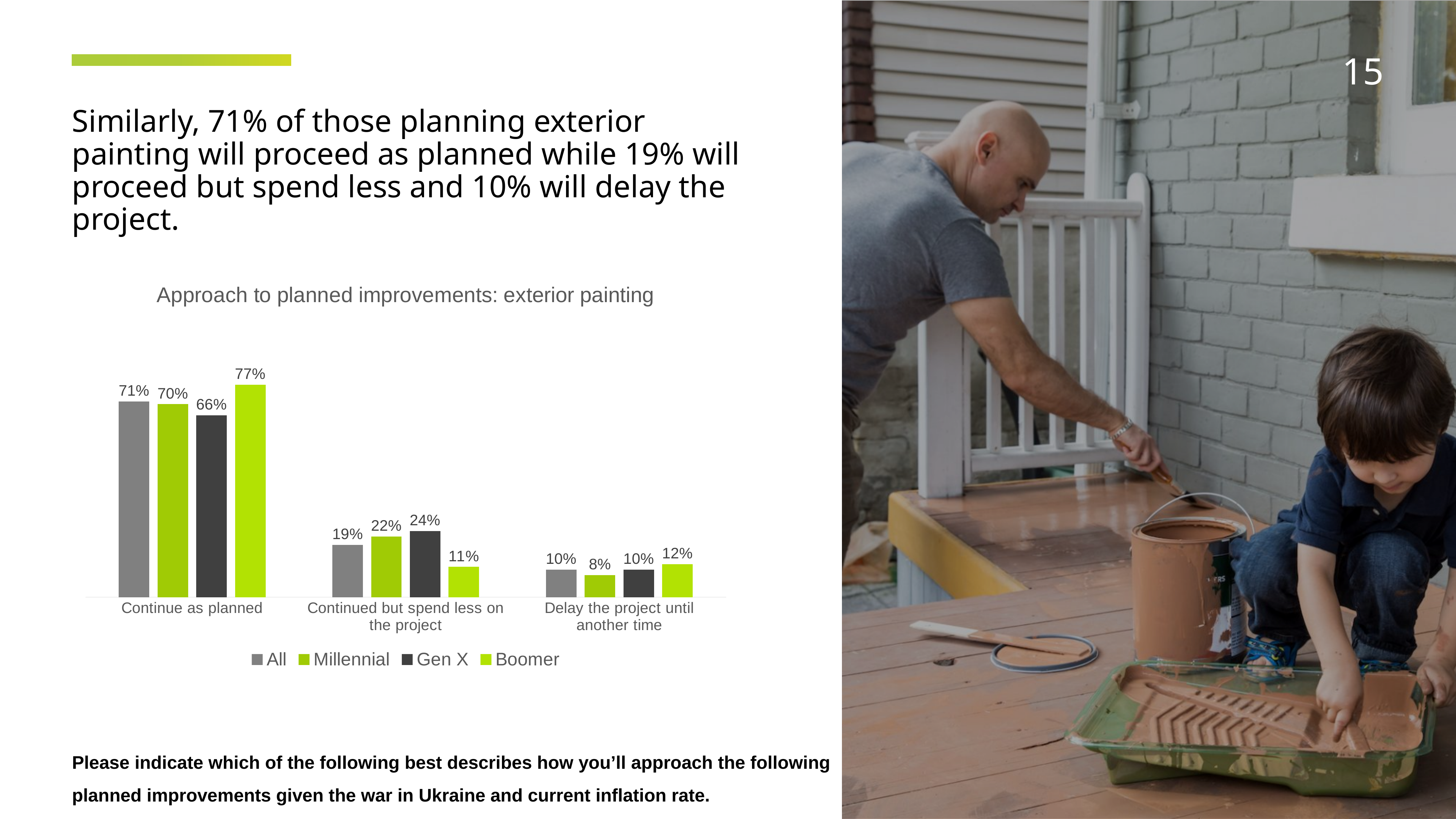
Which is larger: the All value or the Gen X value for 'Continue as planned'? All What is the difference between the Gen X and Boomer values in the 'Continued but spend less on the project' category? 13% What is the value for Boomer in the 'Continue as planned' category? 77% Which series has the highest value in the 'Continue as planned' category? Boomer How many series does the legend list? 4 What is the value for Millennial in the 'Delay the project until another time' category? 8% Which series has the lowest value in the 'Continued but spend less on the project' category? Boomer What is the difference between the All values for 'Continue as planned' and 'Delay the project until another time'? 61% What is the title of the chart? Approach to planned improvements: exterior painting What kind of chart is shown on the slide? Bar chart How many categories are shown on the x axis? 3 What is the value for Gen X in the 'Continued but spend less on the project' category? 24%